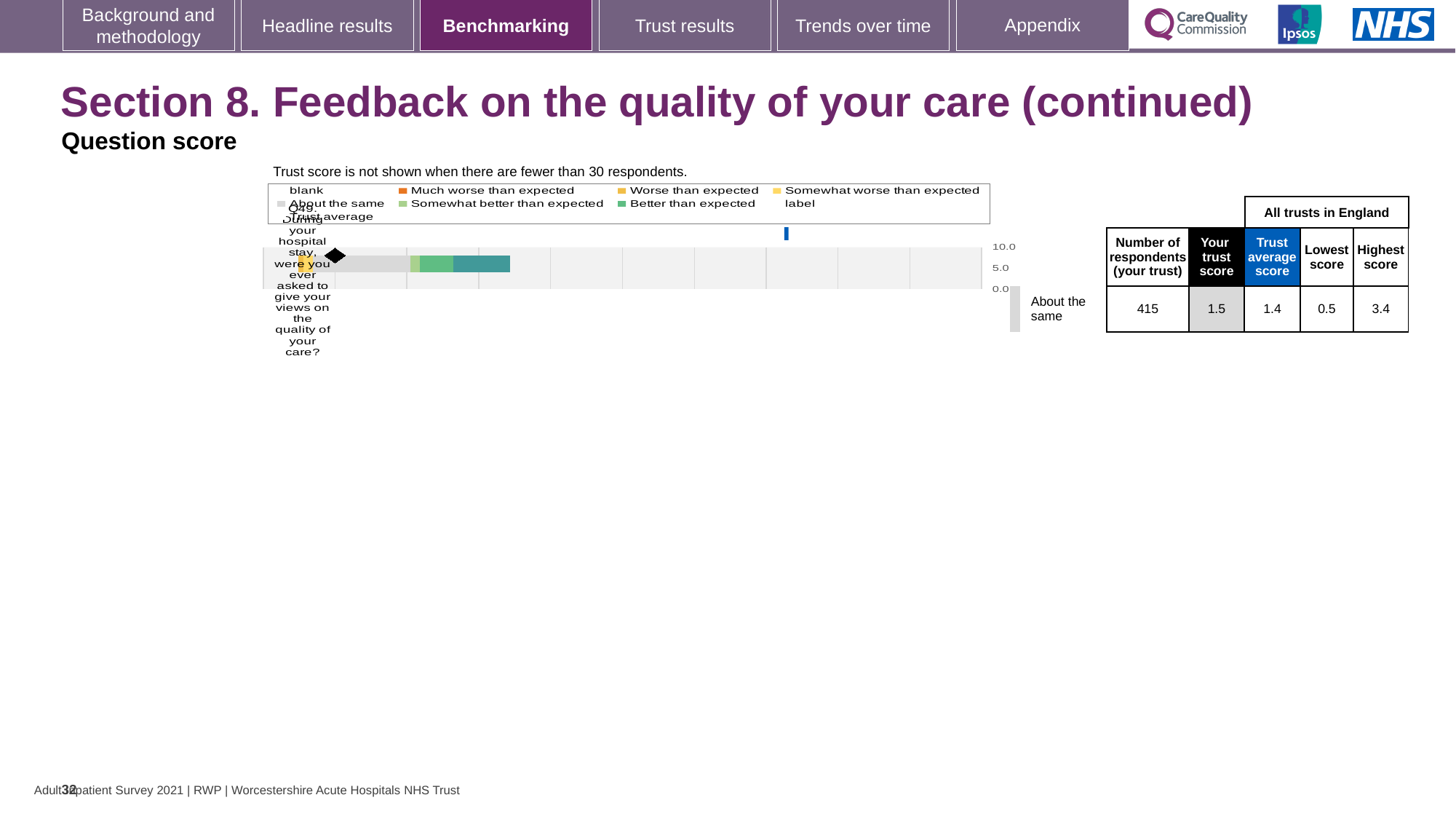
What is the highest score among all trusts in England for Q49? 3.4 Which benchmarking category is the trust's Q49 score placed in? About the same What is the trust average score for Q49? 1.4 How many respondents from the trust answered Q49? 415 What is the trust score for Q49 (During your hospital stay, were you ever asked to give your views on the quality of your care?)? 1.5 What is the difference between the highest and lowest scores for Q49 across all trusts in England? 2.9 What is the highest value shown on the chart's axis? 10.0 What type of chart is used to show the Q49 benchmarking result? bar chart Which is larger for Q49: the trust score or the trust average score? the trust score How many questions (categories) are plotted on the benchmarking chart? 1 Is the trust score marker for Q49 greater or less than 5.0 on the chart axis? less What is the lowest score among all trusts in England for Q49? 0.5